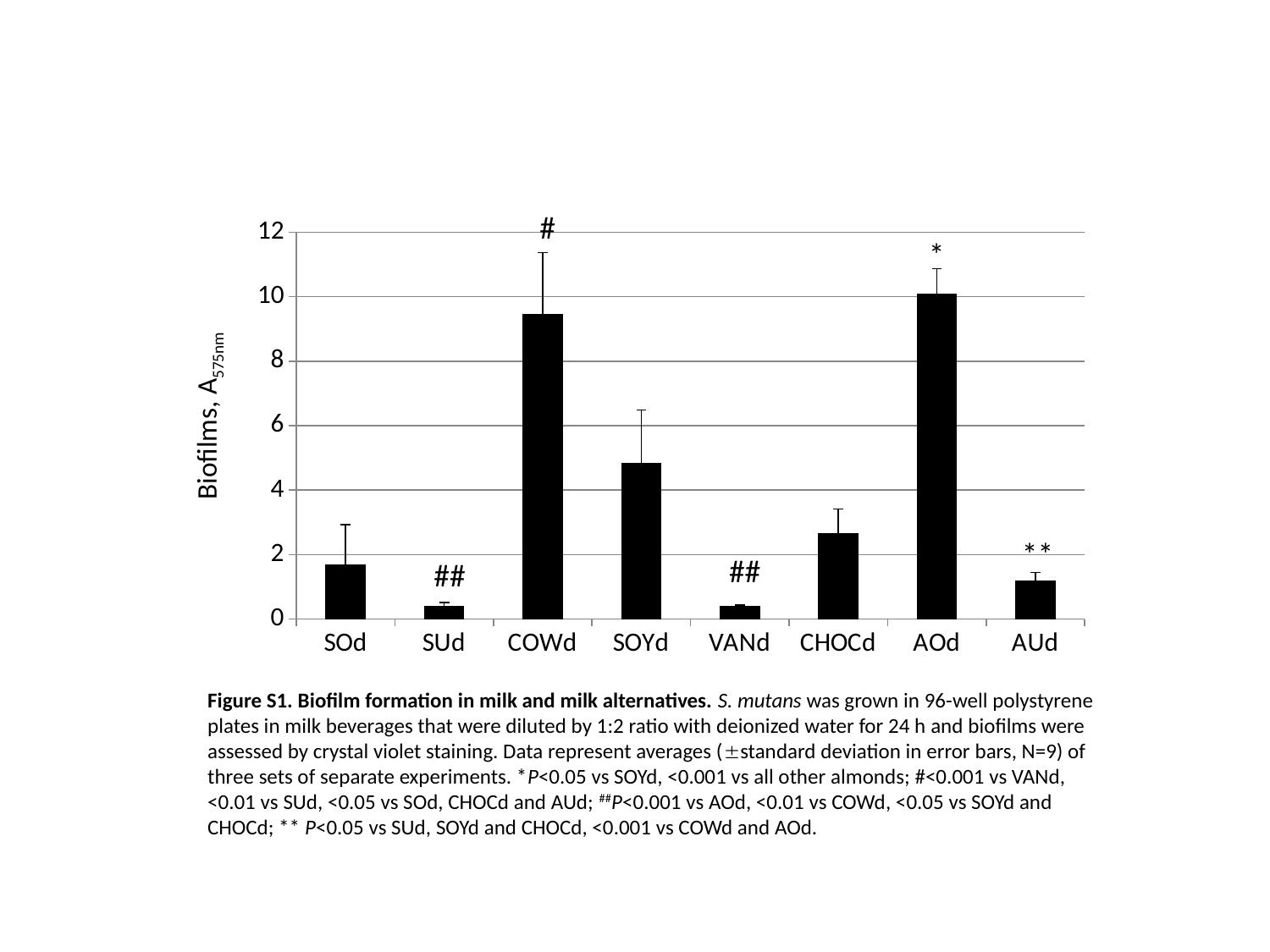
Which is larger, the value for AOd or the value for AUd? AOd How many categories are plotted along the x axis? 8 Which category's bar is marked with the '#' symbol? COWd Which is larger, the value for CHOCd or the value for SOd? CHOCd Is the value for SOYd greater or less than 6? less Which is larger, the value for COWd or the value for SOYd? COWd Is the value for CHOCd greater or less than 4? less Is the value for COWd greater or less than 8? greater What kind of chart is shown on the slide? bar chart Which category has the highest biofilm value? AOd